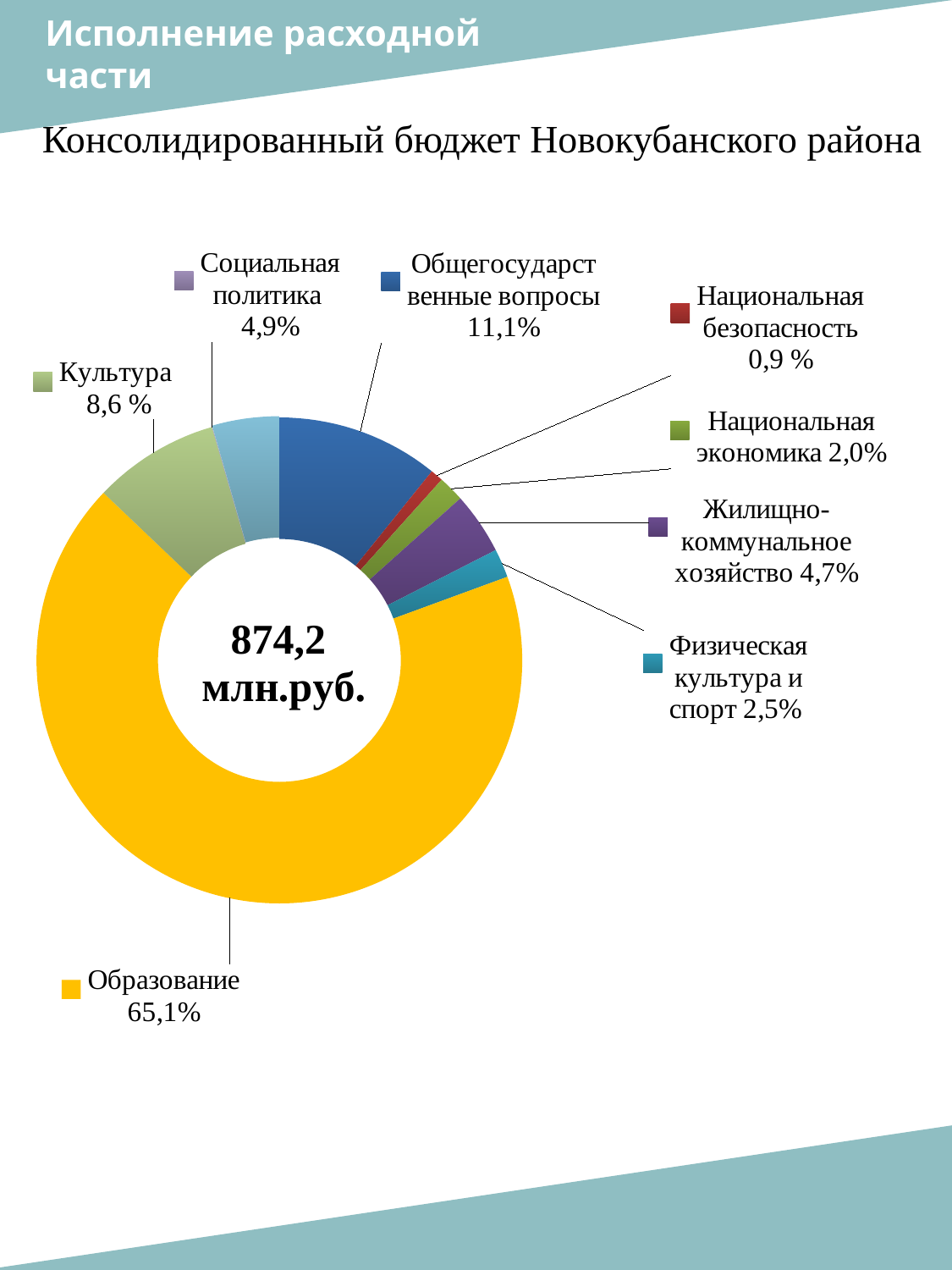
What total amount is printed in the centre of the chart? 874,2 млн.руб. How many categories are shown in the chart? 8 What share of the budget goes to Культура? 8,6 % Which category has the largest share of the budget? Образование Which has a larger share: Социальная политика or Физическая культура и спорт? Социальная политика Which category has the smallest share of the budget? Национальная безопасность What colour is the Образование segment? Yellow What share of the budget goes to Образование? 65,1% What share of the budget goes to Общегосударственные вопросы? 11,1% What share of the budget goes to Жилищно-коммунальное хозяйство? 4,7% What kind of chart is shown on the slide? Pie (doughnut) chart What is the difference in percentage points between Общегосударственные вопросы and Культура? 2,5